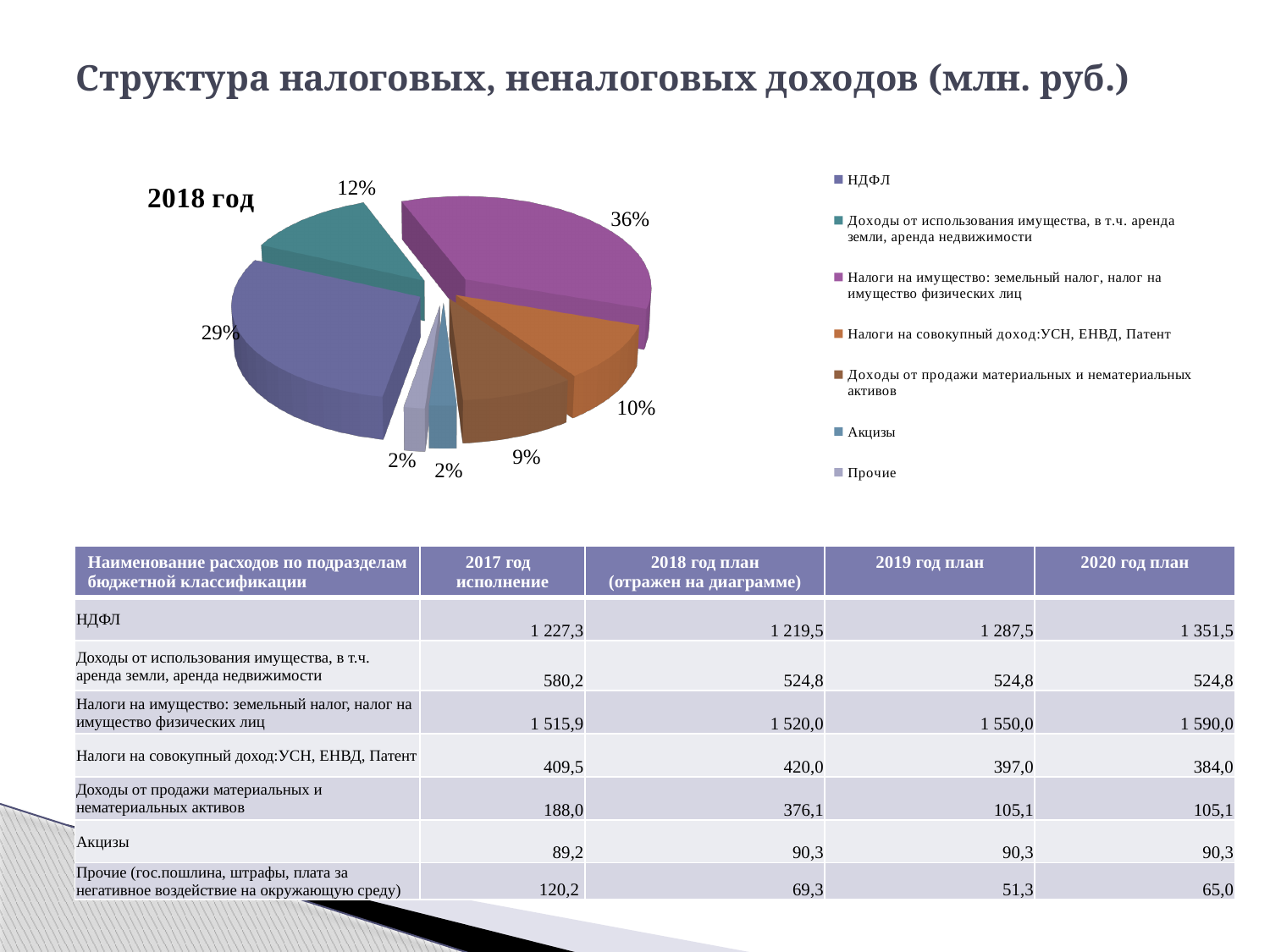
What is the difference in percentage points between the "Налоги на имущество" slice and the "НДФЛ" slice? 7 Which category has the largest slice in the 2018 pie chart? Налоги на имущество: земельный налог, налог на имущество физических лиц What percentage is shown for "Доходы от продажи материальных и нематериальных активов" in the pie chart? 9% What kind of chart is shown on the slide? Pie chart What percentage is shown for "Доходы от использования имущества, в т.ч. аренда земли, аренда недвижимости" in the pie chart? 12% What percentage is shown for "Акцизы" in the pie chart? 2% How many categories does the legend of the pie chart list? 7 What percentage is shown for "Налоги на совокупный доход:УСН, ЕНВД, Патент" in the pie chart? 10% Which slice is larger in the pie chart: "НДФЛ" or "Доходы от использования имущества"? НДФЛ Which year is the pie chart labelled with? 2018 год What share of the 2018 pie chart does "НДФЛ" have? 29% What share of the 2018 pie chart is labelled for "Налоги на имущество: земельный налог, налог на имущество физических лиц"? 36%